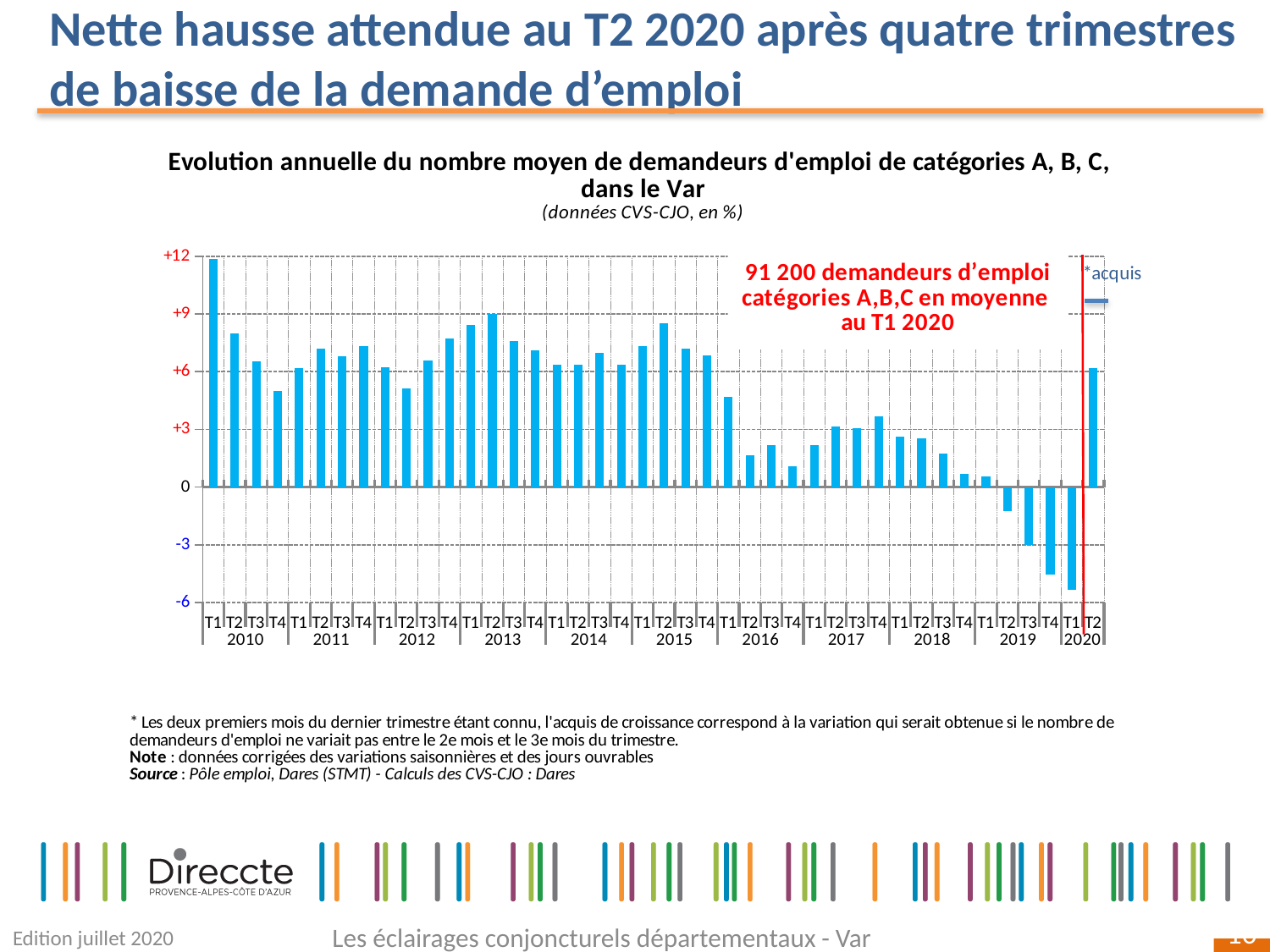
According to the annotation on the chart, how many demandeurs d'emploi catégories A,B,C were there on average in T1 2020? 91 200 Is the value for T2 2020 greater or less than +3? greater Is the value for T4 2018 greater or less than +3? less Do the values rise or fall from T1 2019 to T1 2020? fall Is the value for T1 2010 greater or less than +9? greater What kind of chart is shown on the slide? bar chart How many quarterly bars are plotted in the chart? 42 Which quarter has the highest value in the chart? T1 2010 Which quarter has the lowest value in the chart? T1 2020 Which is larger, the value for T2 2013 or the value for T2 2016? T2 2013